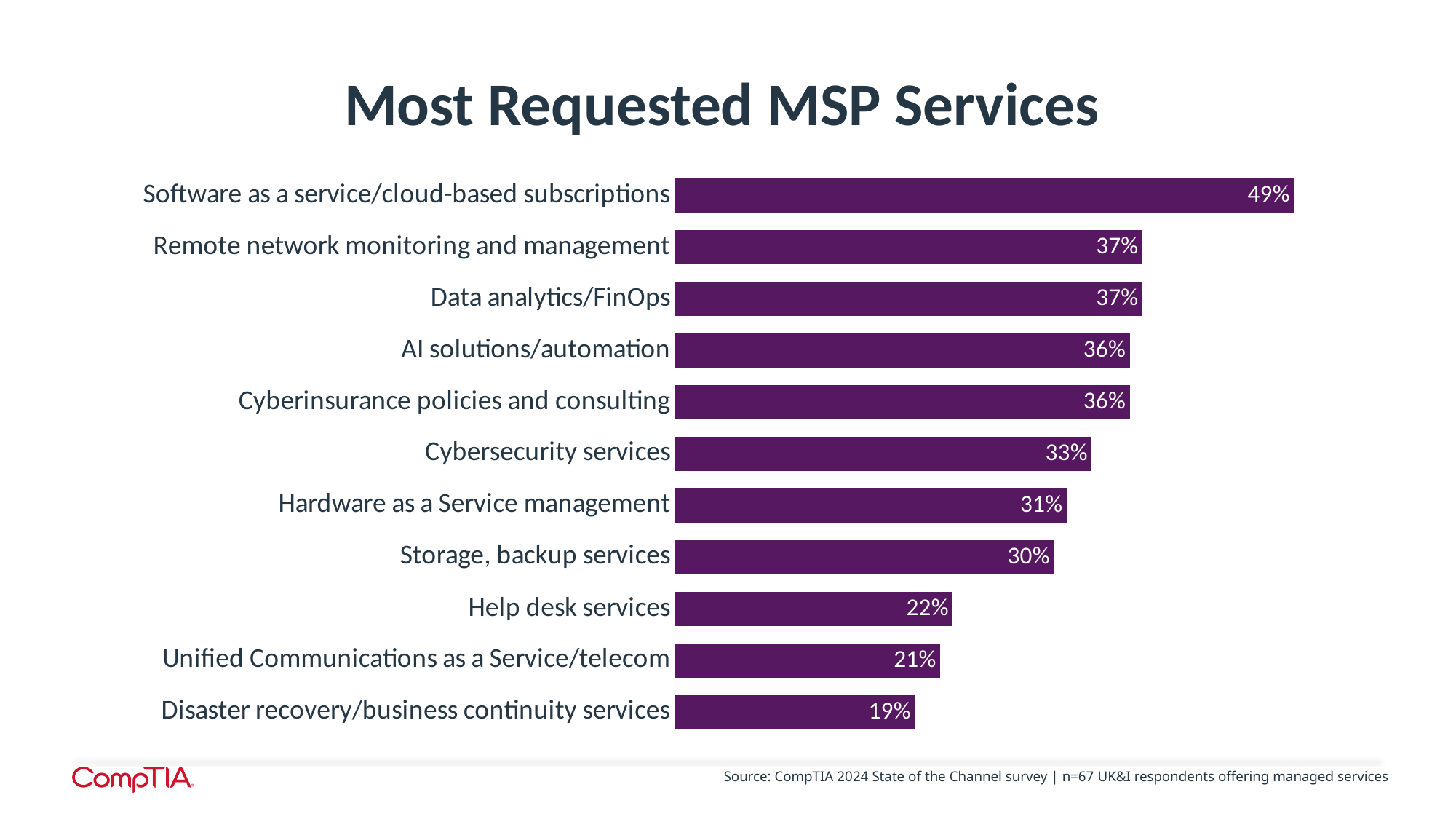
How many services are shown in the chart? 11 What is the difference between the values for Software as a service/cloud-based subscriptions and Remote network monitoring and management? 12% What is the value for Help desk services? 22% Which service has the highest percentage? Software as a service/cloud-based subscriptions What kind of chart is shown on the slide? Bar chart What percentage is shown for Software as a service/cloud-based subscriptions? 49% Which service has the lowest percentage? Disaster recovery/business continuity services Which has a larger value, Cybersecurity services or Unified Communications as a Service/telecom? Cybersecurity services Which has a larger value, Hardware as a Service management or Help desk services? Hardware as a Service management What percentage is shown for Cybersecurity services? 33% What is the title of the chart? Most Requested MSP Services What is the difference between the values for Storage, backup services and Disaster recovery/business continuity services? 11%